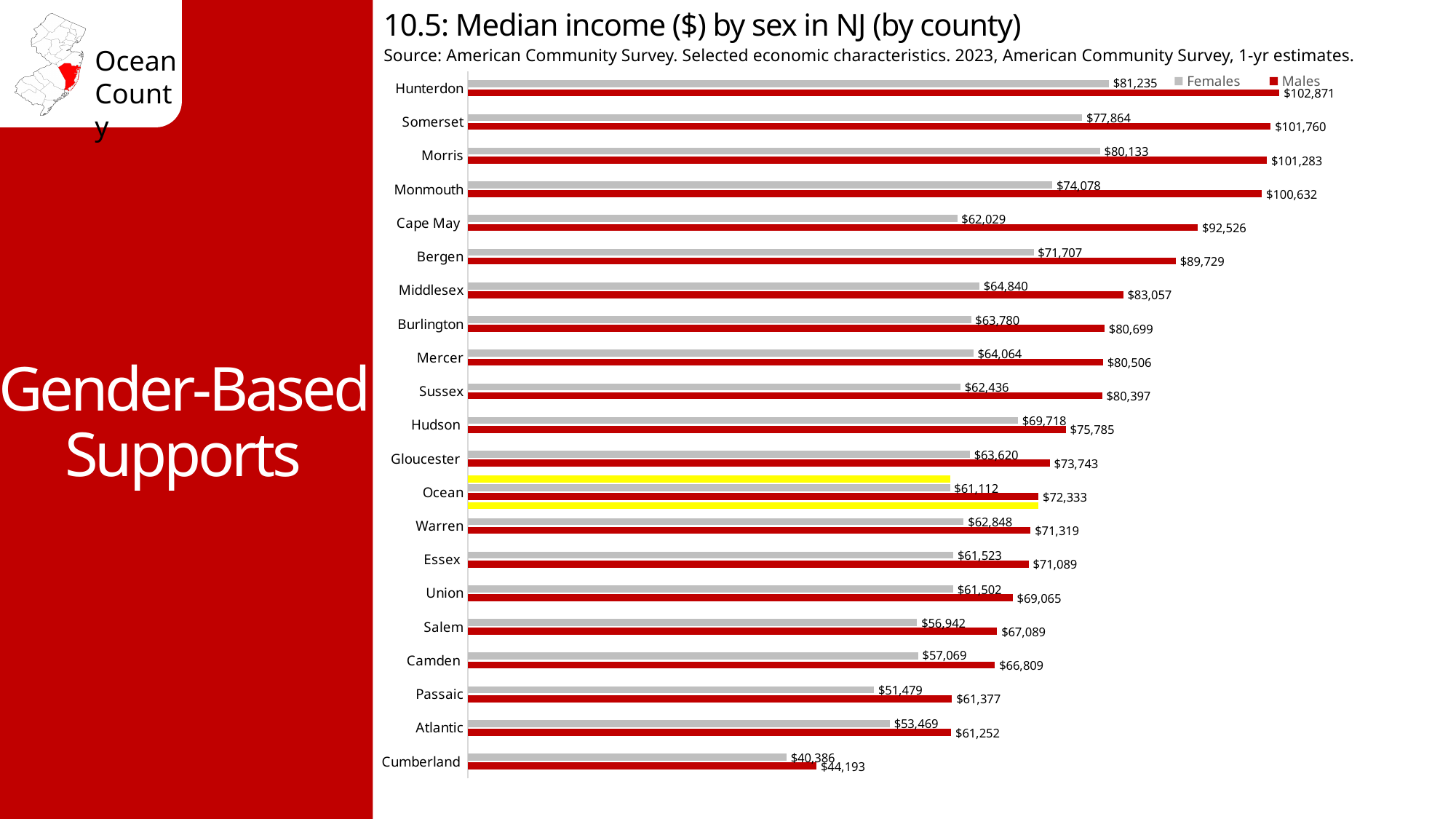
What type of chart is used on this slide? Bar chart How many series does the legend list? 2 Which county has the lowest median income for females? Cumberland What is the median income for males in Cape May? $92,526 Which county has the highest median income for males? Hunterdon What is the difference between male and female median income in Hunterdon? $21,636 What is the median income for females in Hudson? $69,718 How many counties are shown in the chart? 21 What is the median income for females in Ocean County? $61,112 What is the difference between male and female median income in Ocean County? $11,221 Which is larger, the female median income in Bergen or in Monmouth? Monmouth What is the median income for males in Ocean County? $72,333